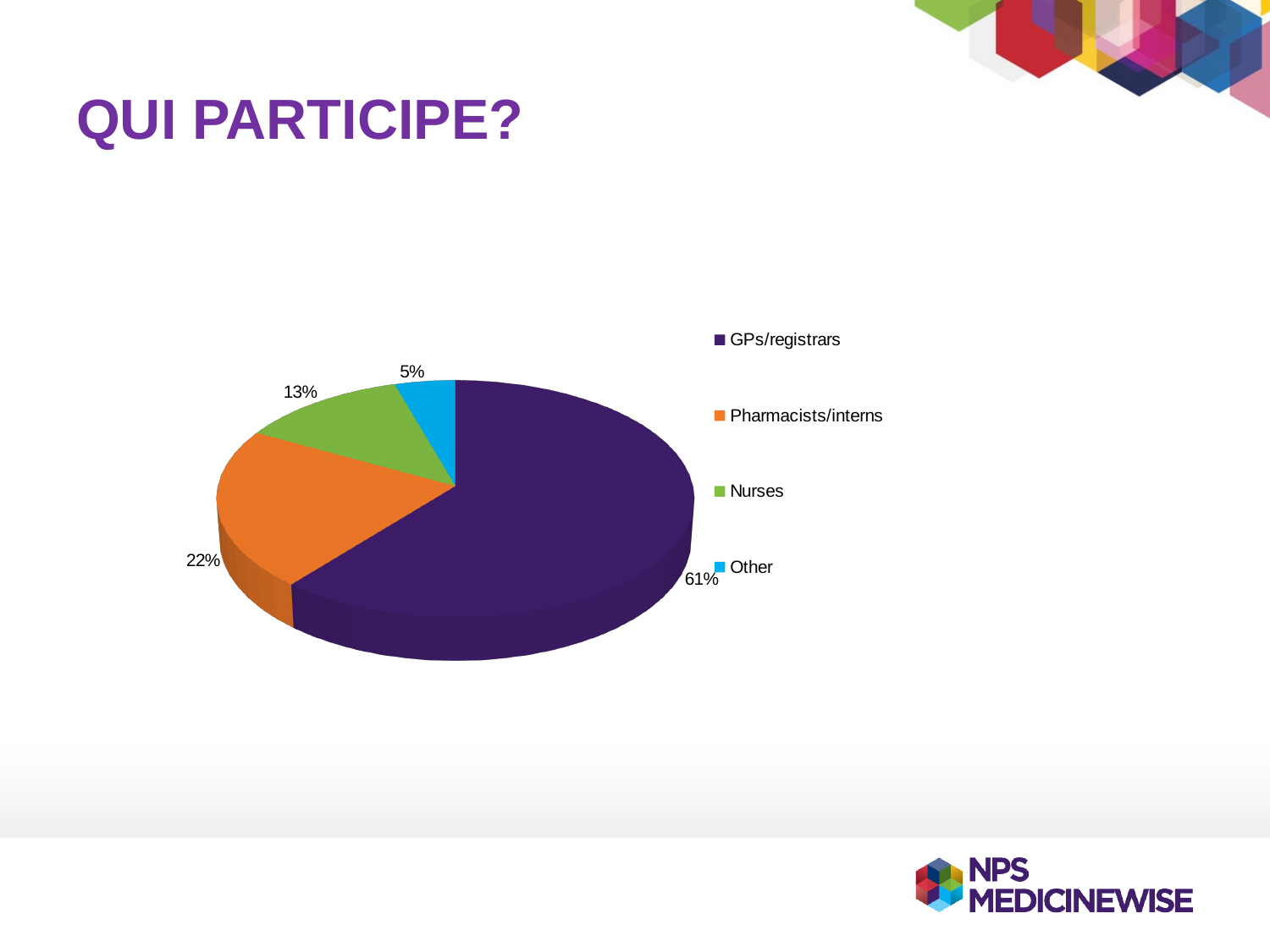
What kind of chart is shown on the slide? Pie chart How many categories does the pie chart show? 4 What colour is the slice for Pharmacists/interns? Orange What is the title of the slide containing the pie chart? QUI PARTICIPE? What percentage of participants fall under Other? 5% What percentage of participants are Nurses? 13% Which category has the smallest share of the pie? Other What is the difference in percentage points between GPs/registrars and Pharmacists/interns? 39 Which is larger, the share for Nurses or the share for Other? Nurses What percentage of participants are GPs/registrars? 61% Which category has the largest share of the pie? GPs/registrars What percentage of participants are Pharmacists/interns? 22%